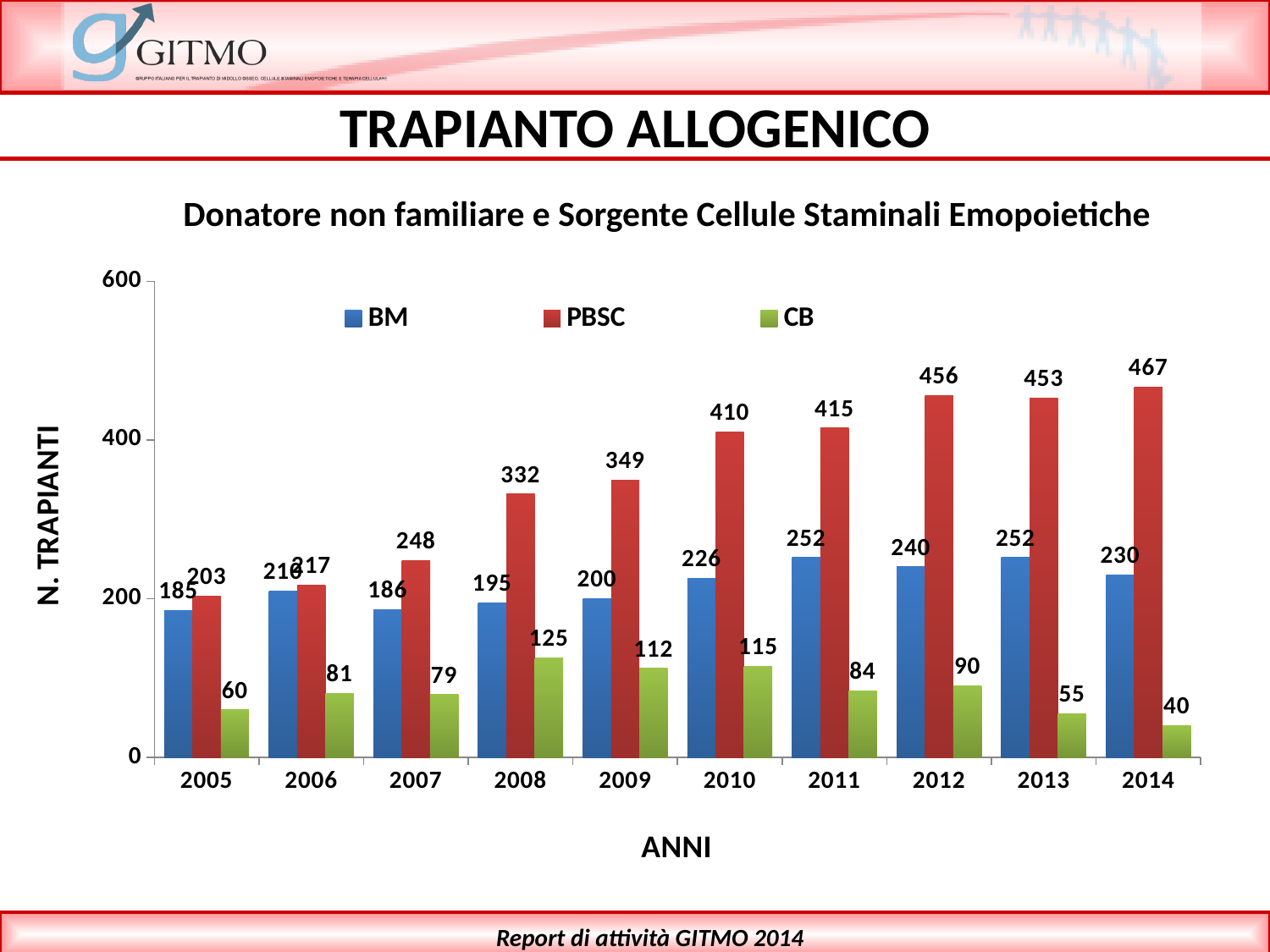
How many years are shown on the x axis? 10 In which year is the PBSC value highest? 2014 Is the PBSC value for 2010 greater or less than 400? greater How many series does the legend list? 3 What is the BM value for 2013? 252 What kind of chart is shown on the slide? bar chart What is the difference between the PBSC and BM values in 2014? 237 In which year is the CB value lowest? 2014 Which is larger, the BM value for 2011 or the BM value for 2012? 2011 Do the PBSC values generally rise or fall from 2005 to 2014? rise What is the PBSC value for 2014? 467 What is the CB value for 2008? 125